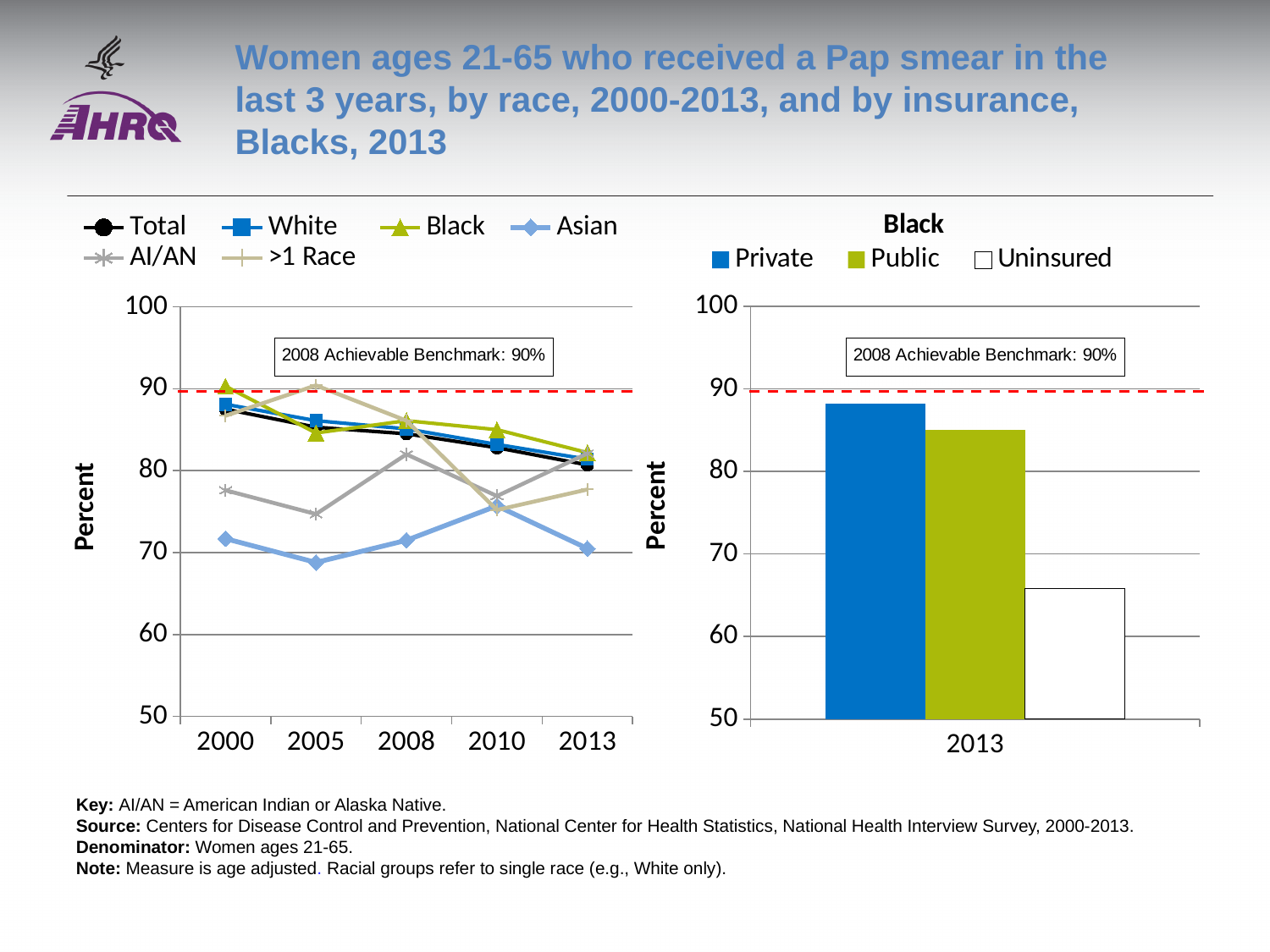
In the left chart (by race), which group had the lowest value in 2000? Asian In the left chart (by race), is the value for Asian in 2005 greater or less than 70? less How many series does the legend of the right chart (Black, by insurance) list? 3 In the right chart (Black, by insurance), is the value for Uninsured greater or less than 70? less In the right chart (Black, by insurance), which insurance group had the highest value in 2013? Private In the left chart (by race), is the value for AI/AN in 2000 greater or less than 80? less How many years are shown on the x axis of the left chart (by race)? 5 In the left chart (by race), does the Total line rise or fall from 2000 to 2013? fall How many series does the legend of the left chart (by race) list? 6 What is the 2008 Achievable Benchmark shown on both charts? 90% What kind of chart is the left chart showing Pap smear rates by race, 2000-2013? line chart What kind of chart is the right chart titled "Black"? bar chart